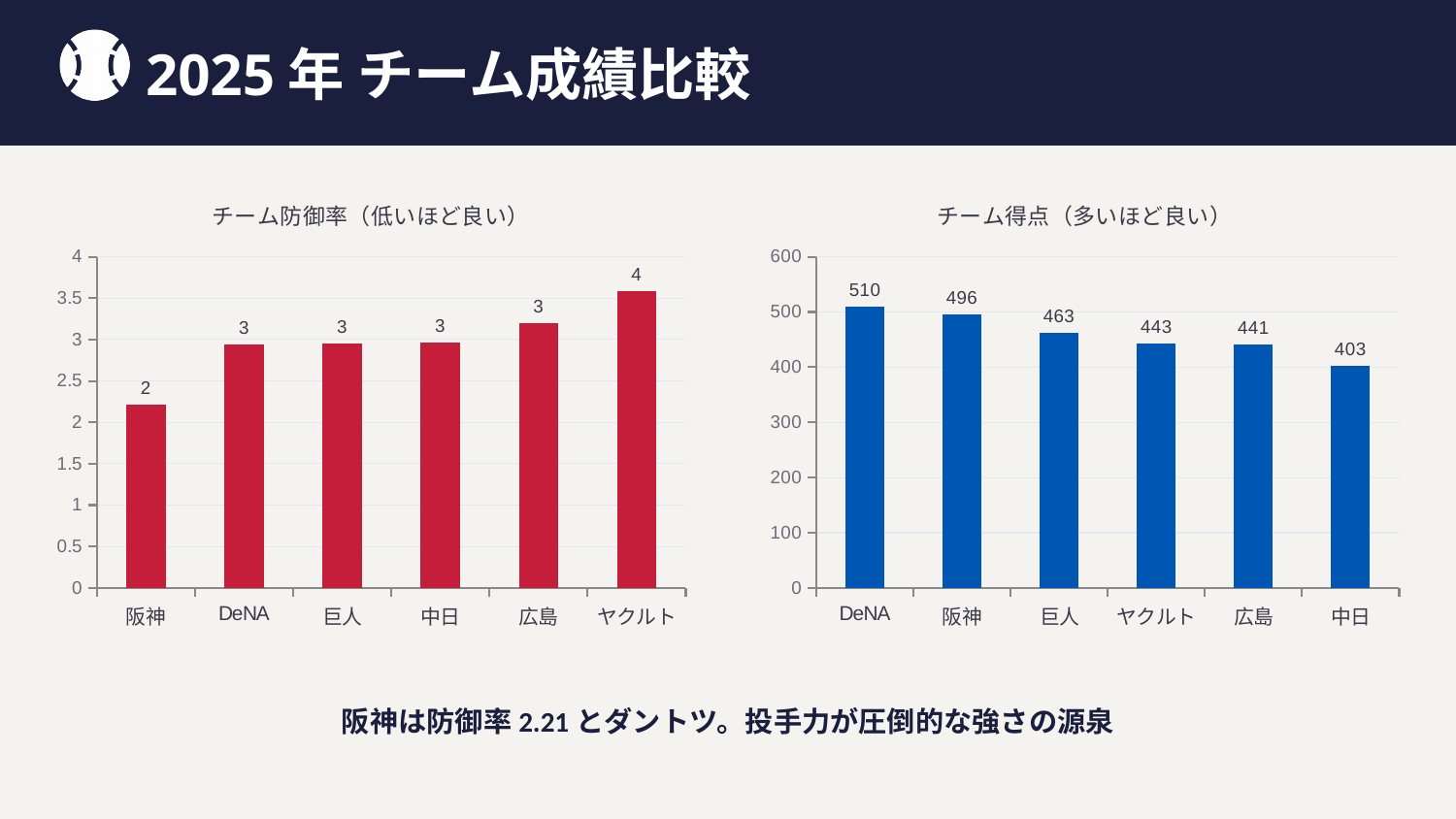
In the チーム得点（多いほど良い） chart, which team has the lowest value? 中日 In the チーム得点（多いほど良い） chart, do the values rise or fall from left to right? fall How many teams are shown in the チーム防御率（低いほど良い） chart? 6 In the チーム得点（多いほど良い） chart, what is the value for 巨人? 463 In the チーム防御率（低いほど良い） chart, which team has the highest value? ヤクルト In the チーム防御率（低いほど良い） chart, which team has the lowest value? 阪神 In the チーム防御率（低いほど良い） chart, is the value for 阪神 greater or less than 2.5? less In the チーム得点（多いほど良い） chart, which team has the highest value? DeNA In the チーム得点（多いほど良い） chart, what is the value for 中日? 403 In the チーム得点（多いほど良い） chart, which is larger, 巨人 or ヤクルト? 巨人 In the チーム得点（多いほど良い） chart, what is the difference between DeNA and 阪神? 14 In the チーム得点（多いほど良い） chart, what is the value for DeNA? 510